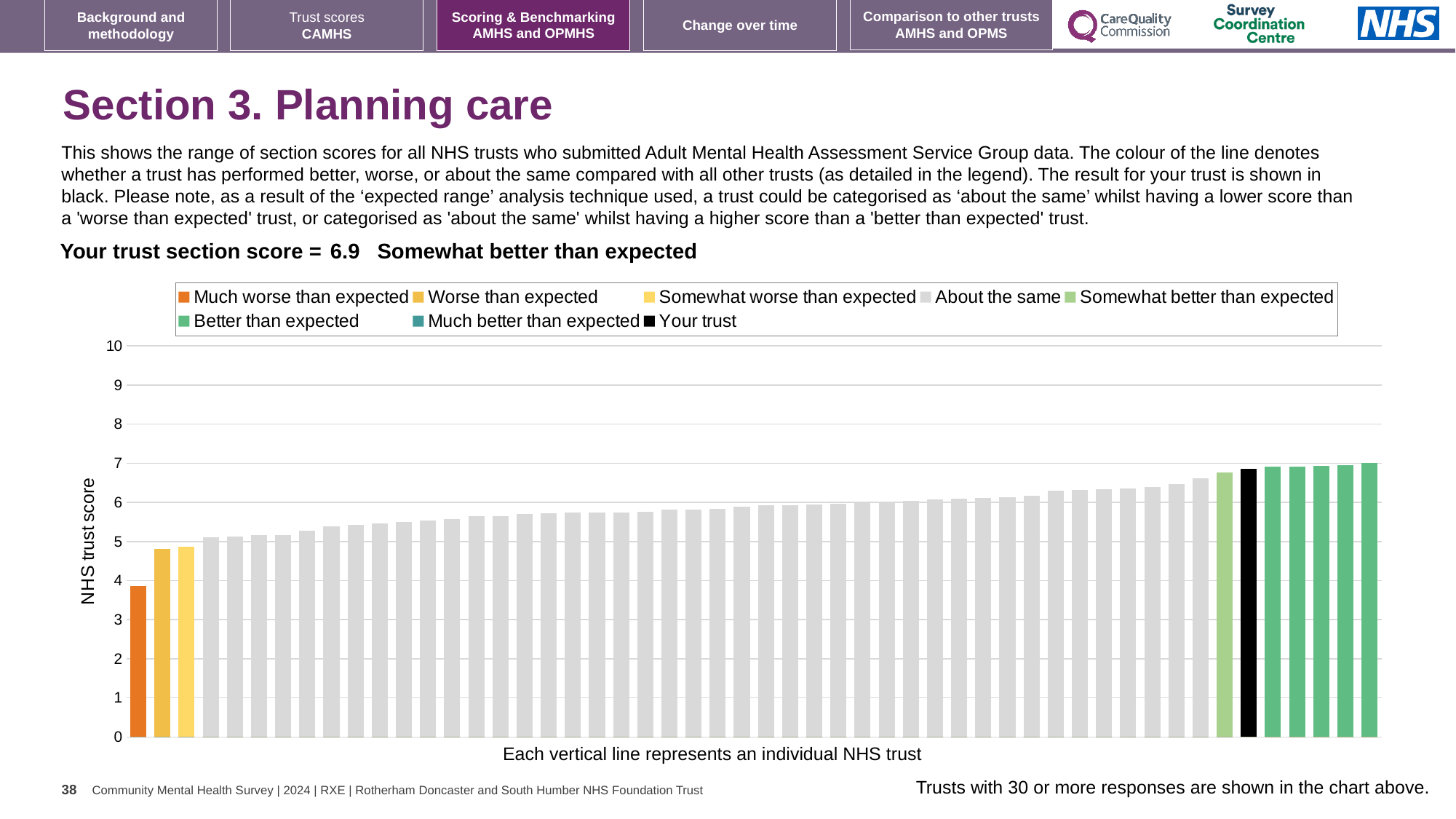
How many bars are coloured as 'Much worse than expected'? 1 What is the section score for your trust? 6.9 Is the value of the black 'Your trust' bar greater or less than 6? greater Which is larger: the leftmost bar or the rightmost bar? the rightmost bar What kind of chart is shown on the slide? bar chart How many entries does the chart legend list? 8 How many bars are coloured as 'Better than expected'? 5 Is the value of the lowest bar (Much worse than expected) greater or less than 4? less Do the bar values rise or fall from left to right along the x axis? rise Which legend category does the lowest bar in the chart belong to? Much worse than expected Which legend category does the highest bar in the chart belong to? Better than expected What is the label on the y axis of the chart? NHS trust score